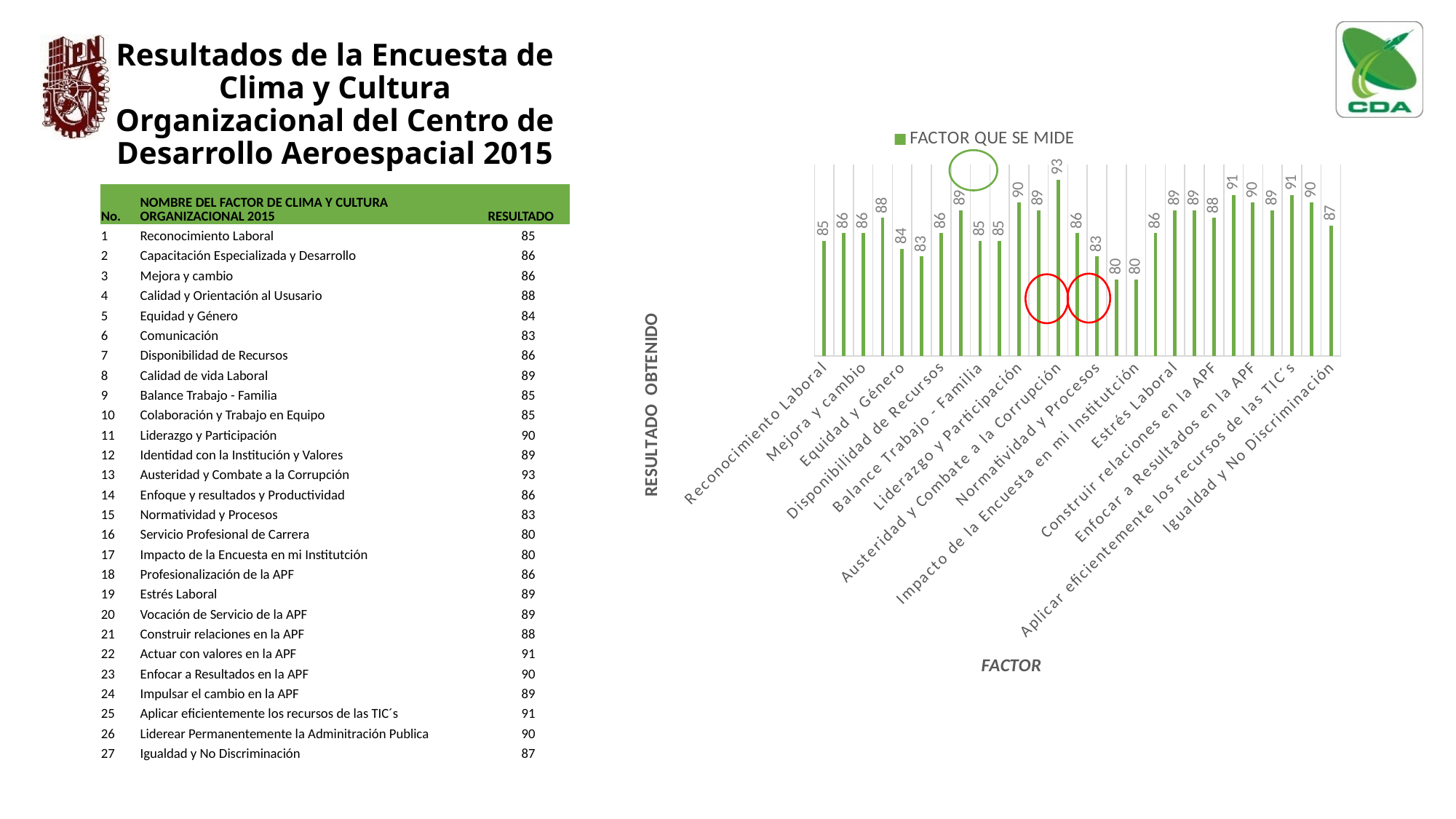
What is the legend entry shown above the chart? FACTOR QUE SE MIDE What is the value for Normatividad y Procesos in the chart? 83 What is the value for Austeridad y Combate a la Corrupción in the chart? 93 What is the value for Igualdad y No Discriminación in the chart? 87 How many bars are plotted in the chart? 27 Which factor has the highest value in the chart? Austeridad y Combate a la Corrupción What is the value for Impacto de la Encuesta en mi Institutción in the chart? 80 What type of chart is shown on the slide? Bar chart Which is larger, the value for Liderazgo y Participación or the value for Equidad y Género? Liderazgo y Participación How many series does the chart legend list? 1 What is the lowest value shown in the chart? 80 What is the difference between the values for Austeridad y Combate a la Corrupción and Normatividad y Procesos? 10